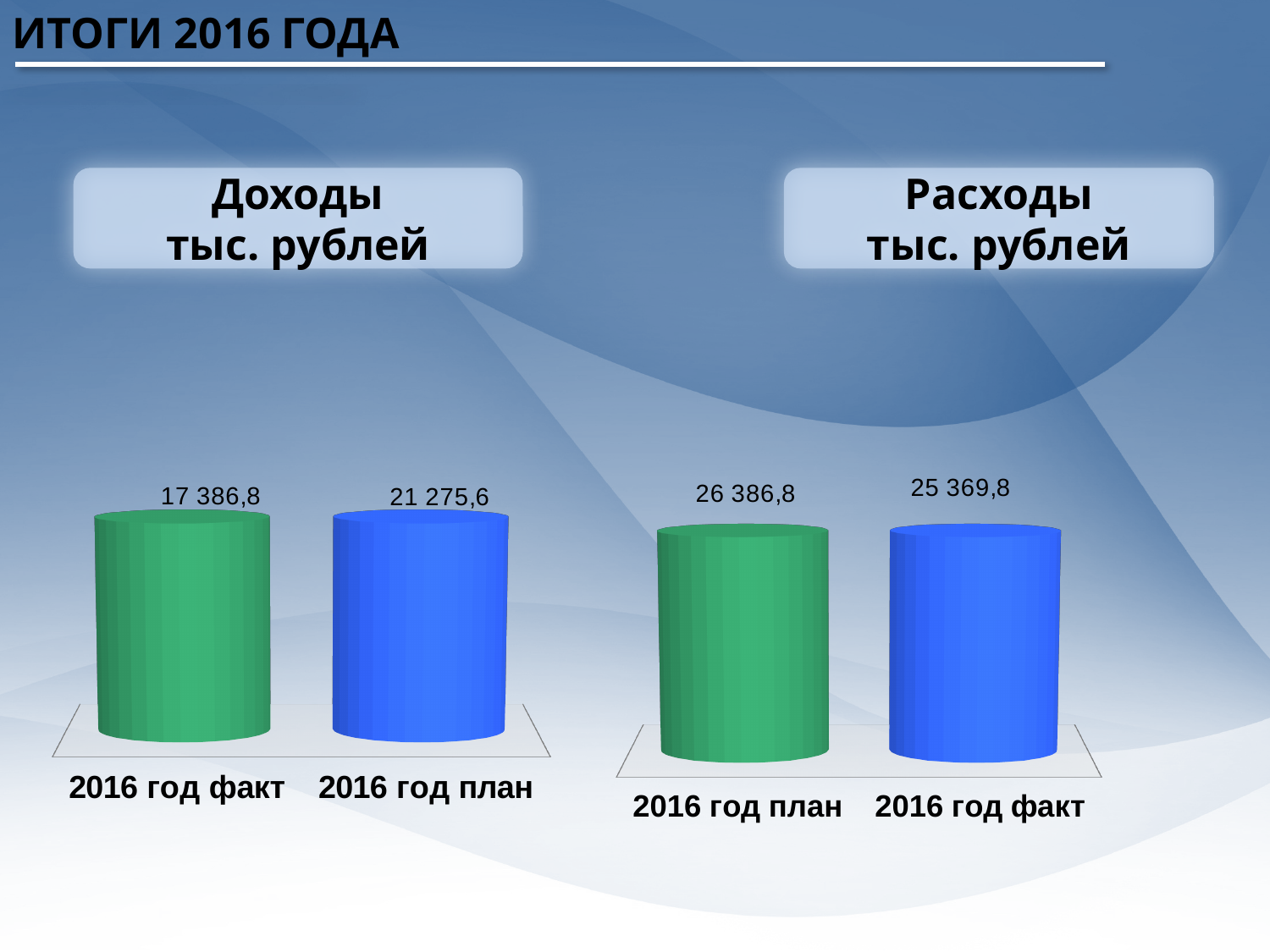
In the Расходы chart, is the value for 2016 год план larger or smaller than the value for 2016 год факт? larger In the Доходы chart, what is the difference between 2016 год план and 2016 год факт? 3 888,8 What kind of chart is the Расходы chart? bar chart In the Доходы chart, what is the value for 2016 год план? 21 275,6 In the Расходы chart, which category has the lower value? 2016 год факт In the Расходы chart, what is the value for 2016 год план? 26 386,8 In the Расходы chart, what is the value for 2016 год факт? 25 369,8 In the Расходы chart, what is the difference between 2016 год план and 2016 год факт? 1 017,0 In the Доходы chart, what is the value for 2016 год факт? 17 386,8 How many bars does the Доходы chart show? 2 What unit is stated in the title of the Доходы chart? тыс. рублей In the Доходы chart, which category has the higher value? 2016 год план